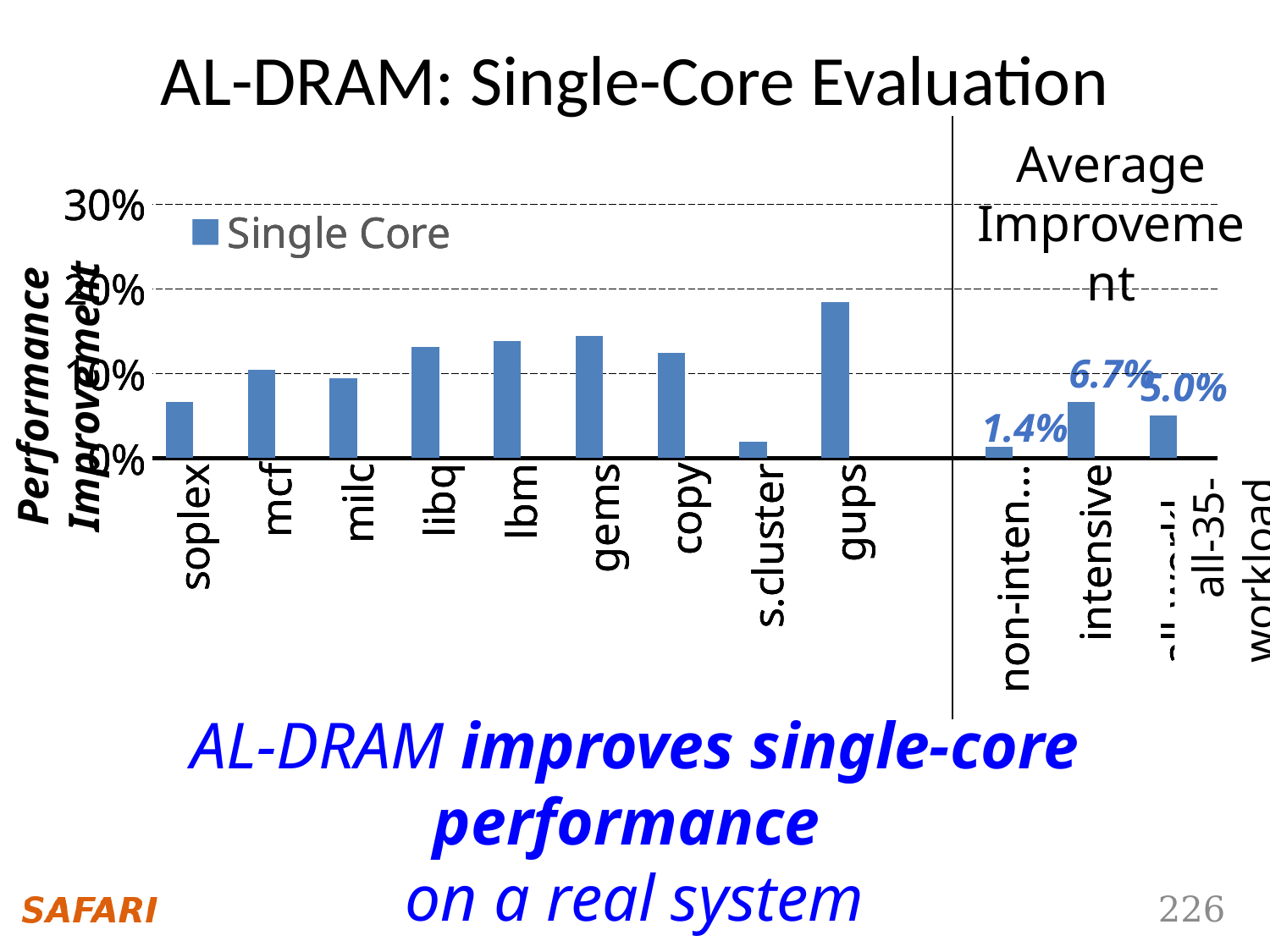
What is the value for the all-35-workload category? 5.0% Is the value for gups greater or less than 10%? greater How many bars are plotted in the chart? 12 Which of the individual benchmarks (left of the divider) has the highest performance improvement? gups What is the value for intensive? 6.7% What kind of chart is shown on the slide? bar chart Which of the individual benchmarks (left of the divider) has the lowest performance improvement? s.cluster Is the value for soplex greater or less than 10%? less What is the difference between the intensive and non-intensive values? 5.3% How many series does the legend list? 1 What is the value for the non-intensive category? 1.4% Which is larger, the value for gups or the value for lbm? gups